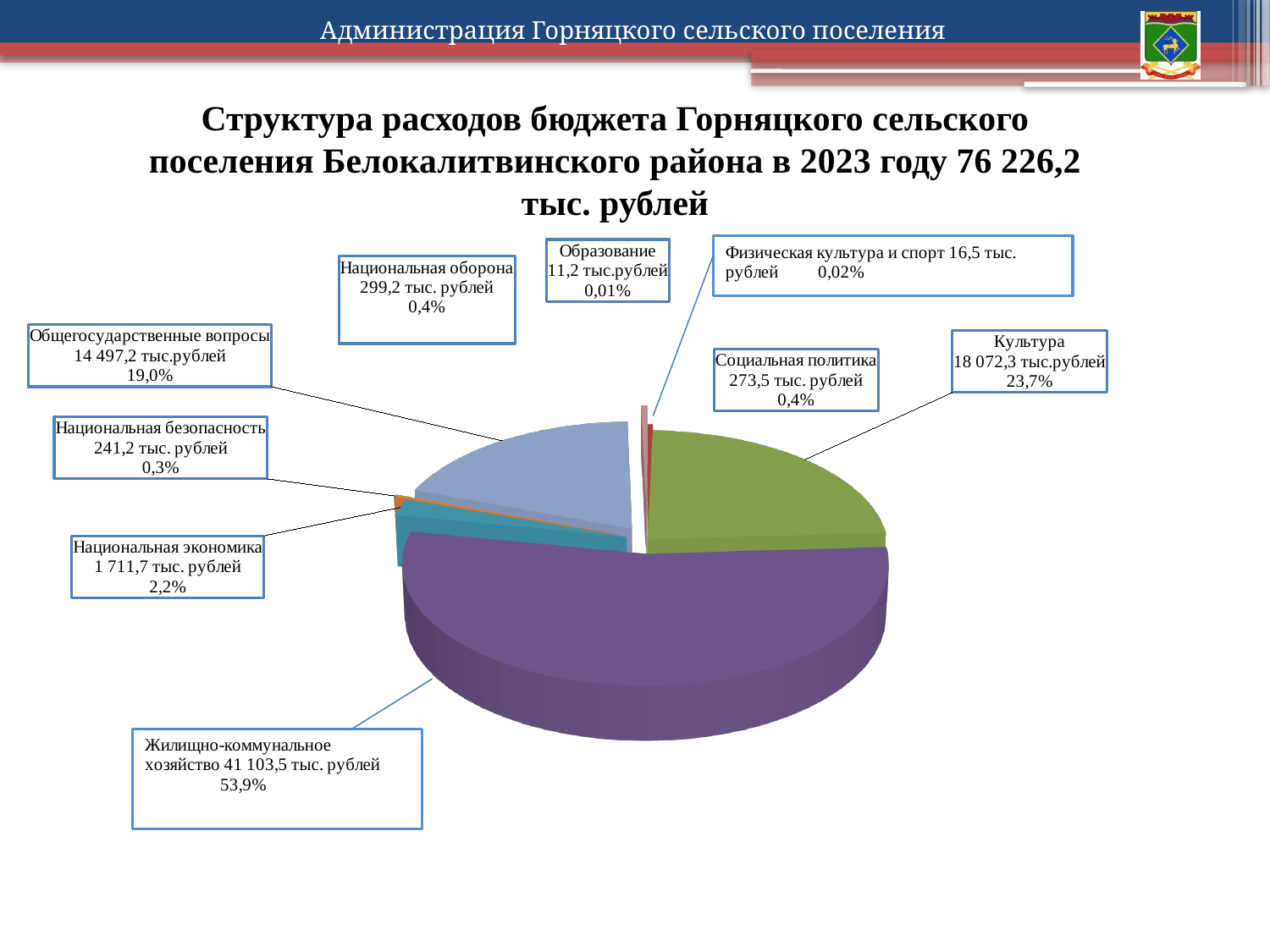
What share of the budget expenditure goes to Жилищно-коммунальное хозяйство? 53,9% What total budget expenditure is stated in the chart title for 2023? 76 226,2 тыс. рублей Which is larger: the amount for Культура or for Общегосударственные вопросы? Культура What is the amount for Национальная оборона? 299,2 тыс. рублей What is the difference in percentage share between Культура (23,7%) and Общегосударственные вопросы (19,0%)? 4,7% What percentage share does Национальная экономика have? 2,2% What is the amount for Культура in the pie chart? 18 072,3 тыс.рублей What type of chart is shown on the slide? pie chart What is the amount for Общегосударственные вопросы? 14 497,2 тыс.рублей How many categories (slices) does the pie chart show? 9 Which category has the largest share of expenditure? Жилищно-коммунальное хозяйство Which category has the smallest share of expenditure? Образование